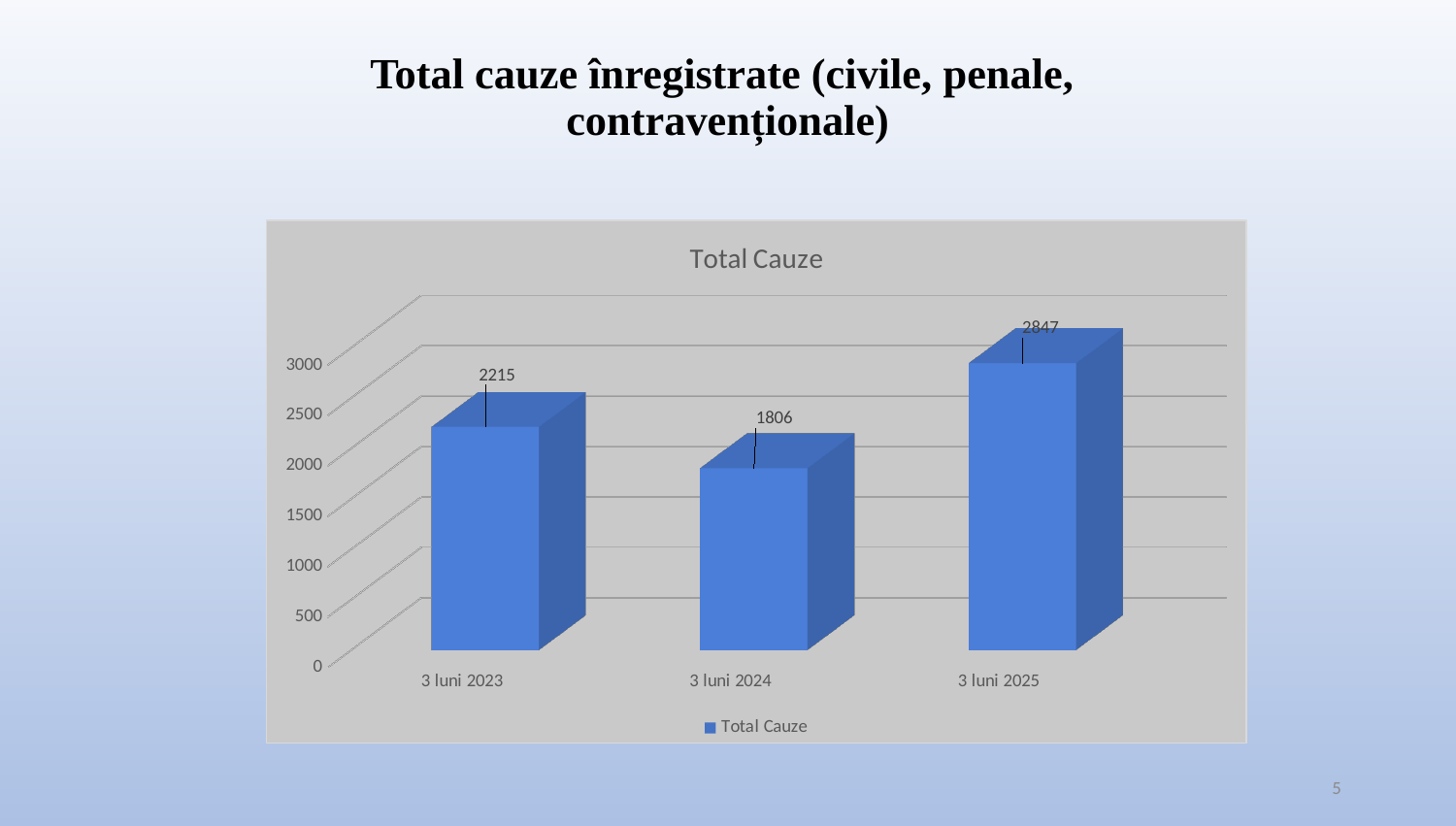
What is the value for 3 luni 2025? 2847 Which category has the lowest value? 3 luni 2024 Which category has the highest value? 3 luni 2025 What kind of chart is shown? bar chart Which is larger, the value for 3 luni 2023 or 3 luni 2025? 3 luni 2025 How many categories are shown on the x axis? 3 What is the value for 3 luni 2023? 2215 Is the value for 3 luni 2024 greater or less than 2000? less What is the value for 3 luni 2024? 1806 What is the title of the chart? Total Cauze What is the difference between the values for 3 luni 2025 and 3 luni 2024? 1041 What is the difference between the values for 3 luni 2023 and 3 luni 2024? 409